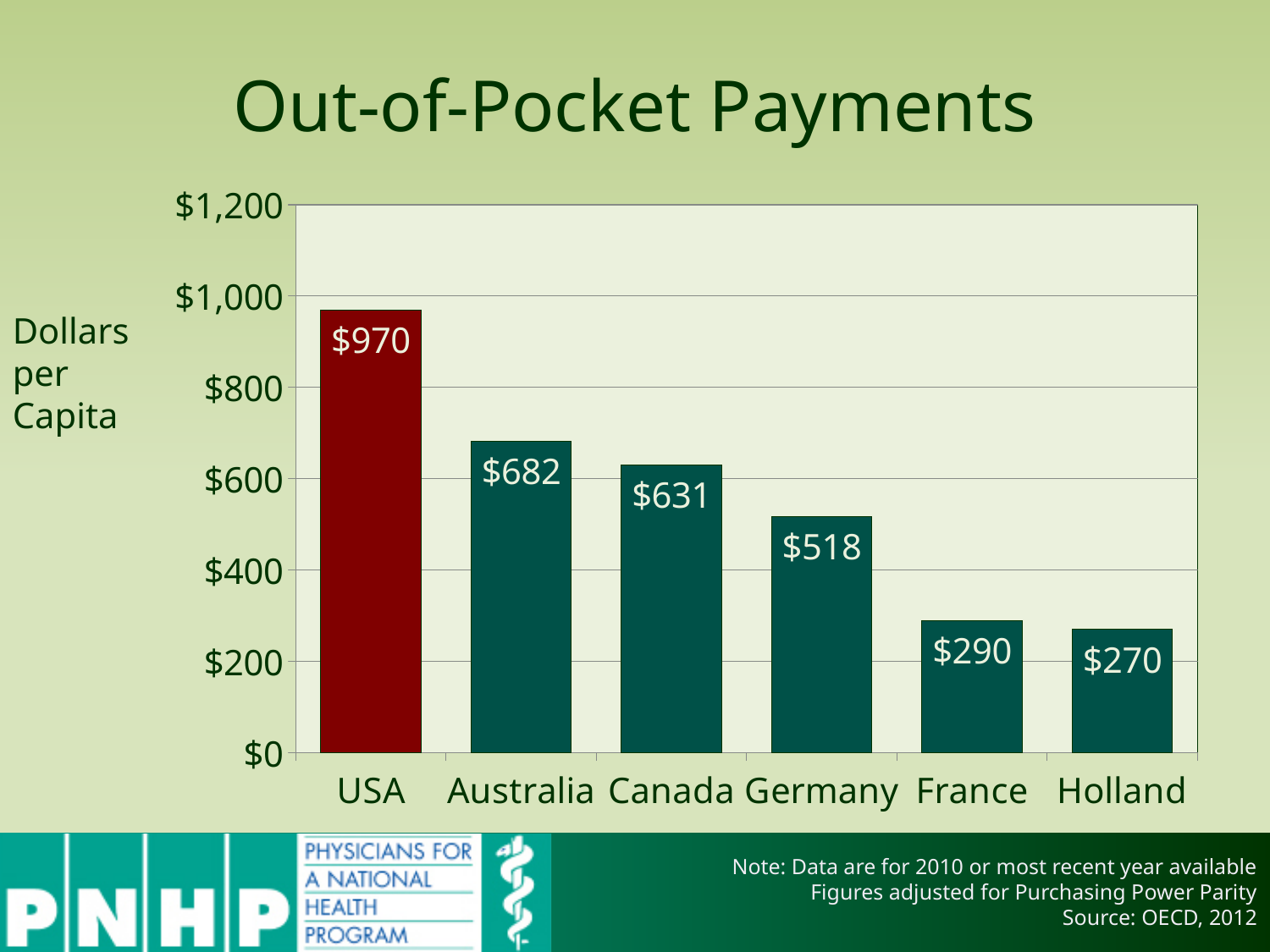
How many countries are shown in the chart? 6 Which country has the lowest out-of-pocket payments per capita? Holland Which country has the highest out-of-pocket payments per capita? USA What is the value shown for Germany? $518 What is the value shown for Holland? $270 What is the difference between the USA and Australia values? $288 What is the difference between the Canada and France values? $341 What kind of chart is shown on the slide? Bar chart Is the value for Germany greater or less than $600? less What is the title of the chart? Out-of-Pocket Payments Which is larger, the value for Australia or the value for Canada? Australia What is the out-of-pocket payment per capita for the USA? $970